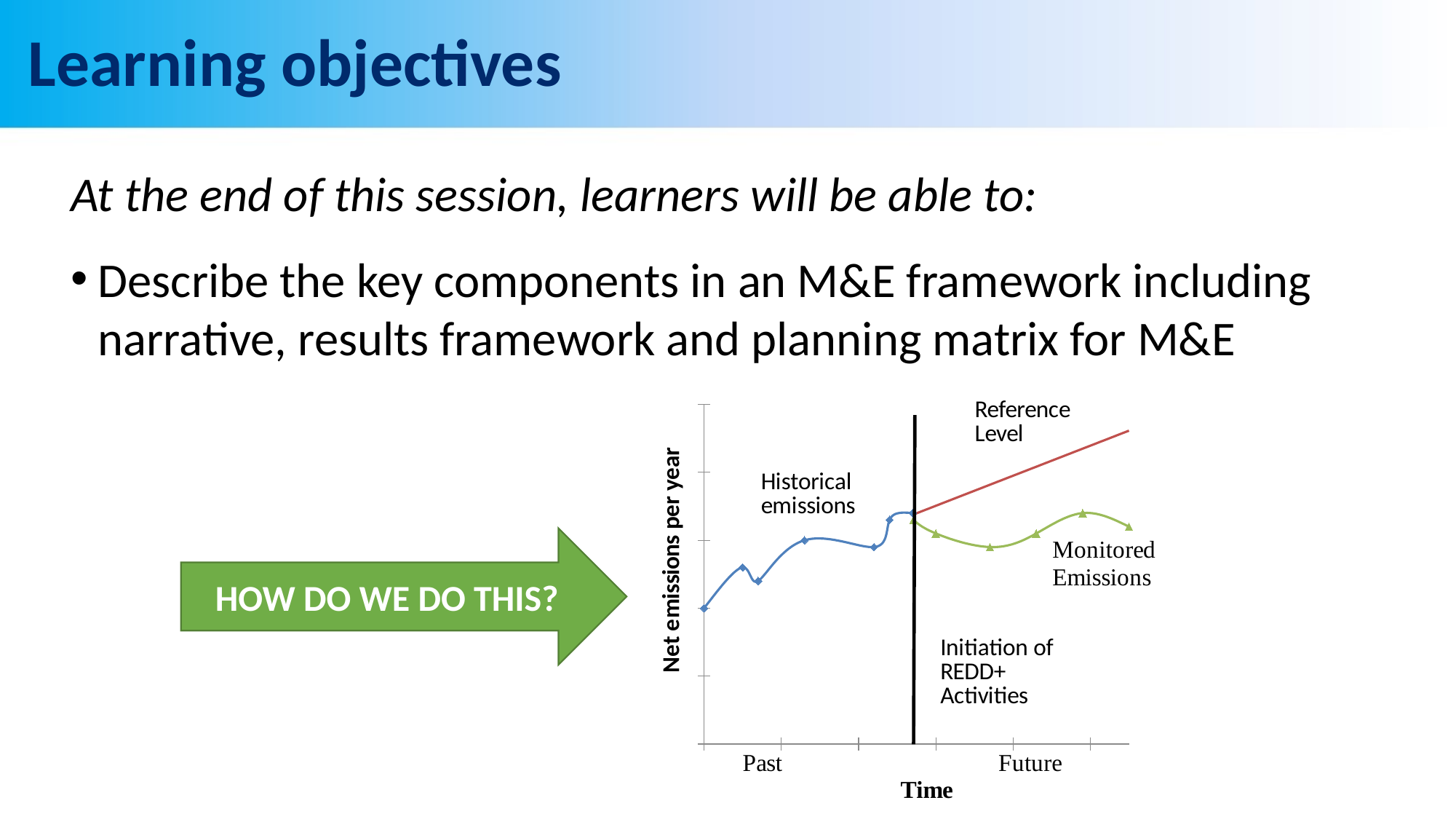
At the right end of the chart, which is higher: the Reference Level or the Monitored Emissions? Reference Level What event does the vertical black line on the chart mark? Initiation of REDD+ Activities Which line is lower in the Future section of the chart, Reference Level or Monitored Emissions? Monitored Emissions What kind of chart is shown on the slide? line chart How many labelled lines (series) are plotted on the chart? 3 Does the Historical emissions line generally rise or fall from the start of the Past toward the initiation of REDD+ activities? rises Which series is plotted to the left of the vertical black line? Historical emissions Does the Reference Level line rise or fall as time moves into the future? rises What is the label of the horizontal axis of the chart? Time What is the label of the vertical axis of the chart? Net emissions per year